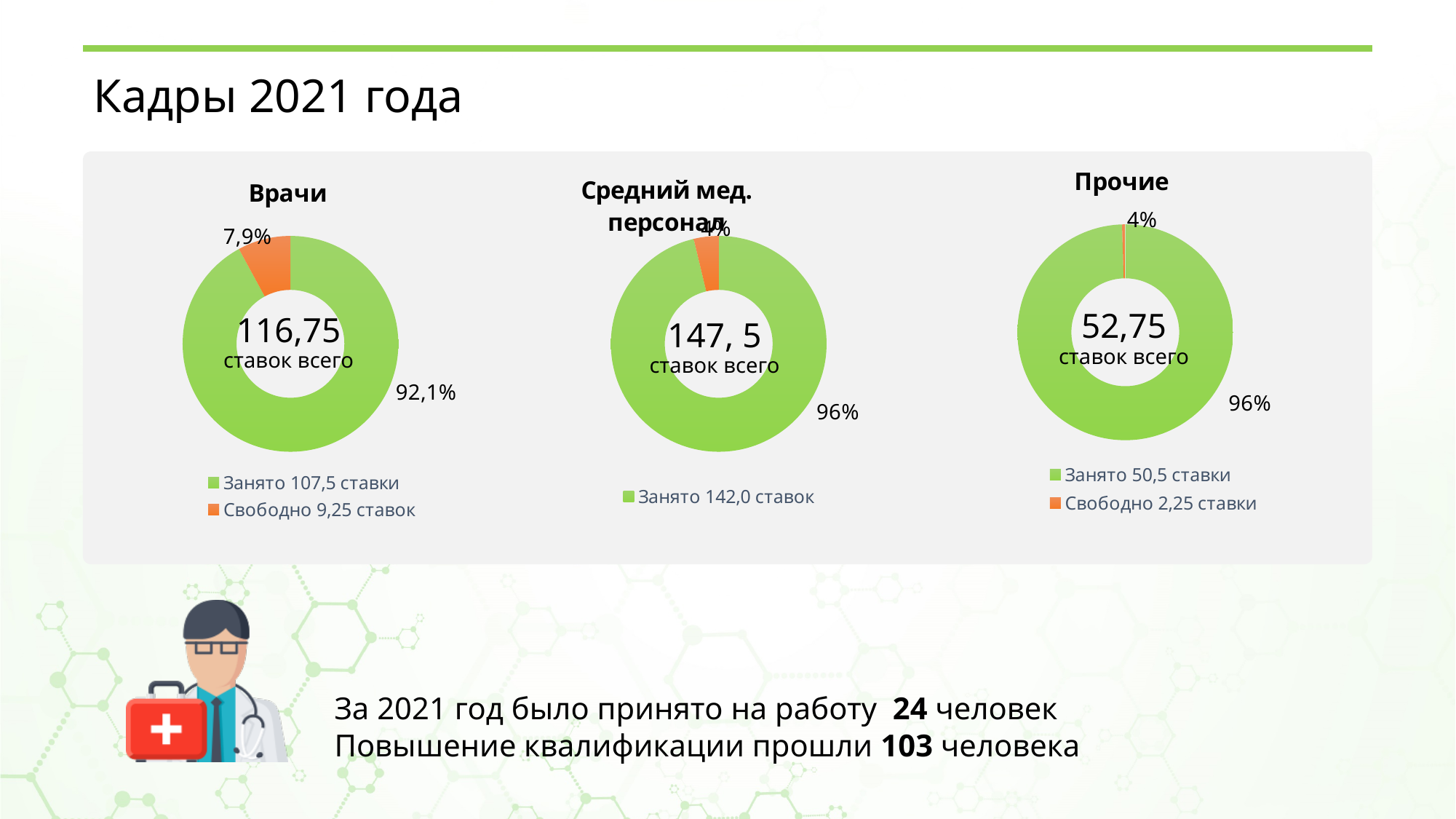
In the "Прочие" chart, what share of positions is shown as free? 4% In the "Врачи" chart, what share of positions is shown as free (Свободно)? 7,9% In the "Прочие" chart, how many positions are occupied according to the legend? 50,5 ставки In the "Врачи" chart, what share of positions is shown as occupied (Занято)? 92,1% What total number of positions is shown in the centre of the "Врачи" chart? 116,75 ставок всего How many legend entries does the "Прочие" chart list? 2 In the "Врачи" chart, how many positions are free according to the legend? 9,25 ставок What total number of positions is shown in the centre of the "Средний мед. персонал" chart? 147, 5 ставок всего In the "Врачи" chart, how many positions are occupied according to the legend? 107,5 ставки What type of chart is used for the "Врачи" chart? Donut (pie) chart In the "Прочие" chart, which slice is larger: Занято or Свободно? Занято